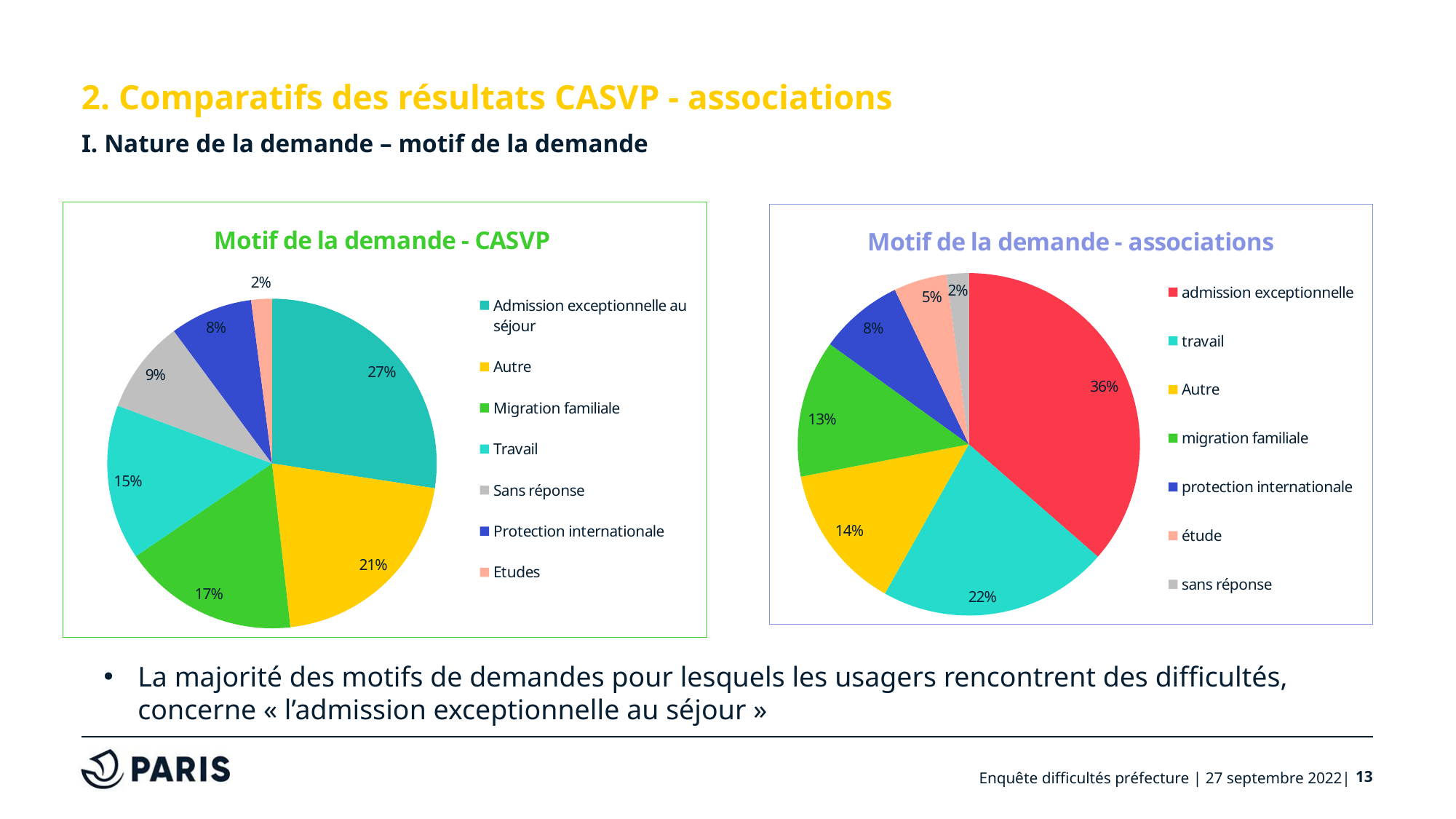
In the 'Motif de la demande - CASVP' chart, which is larger: 'Sans réponse' or 'Protection internationale'? Sans réponse In the 'Motif de la demande - associations' chart, what share does 'étude' have? 5% In the 'Motif de la demande - CASVP' chart, what is the difference between the shares of 'Autre' and 'Migration familiale'? 4% In the 'Motif de la demande - CASVP' chart, what share does 'Autre' have? 21% In the 'Motif de la demande - associations' chart, what share does 'travail' have? 22% How many categories does the 'Motif de la demande - associations' chart show? 7 In the 'Motif de la demande - associations' chart, what colour is the 'admission exceptionnelle' slice? Red In the 'Motif de la demande - associations' chart, which category has the smallest share? sans réponse In the 'Motif de la demande - associations' chart, what is the difference between the shares of 'admission exceptionnelle' and 'travail'? 14% In the 'Motif de la demande - CASVP' chart, what share does 'Travail' have? 15% In the 'Motif de la demande - CASVP' chart, which category has the largest share? Admission exceptionnelle au séjour What type of chart is 'Motif de la demande - CASVP'? Pie chart